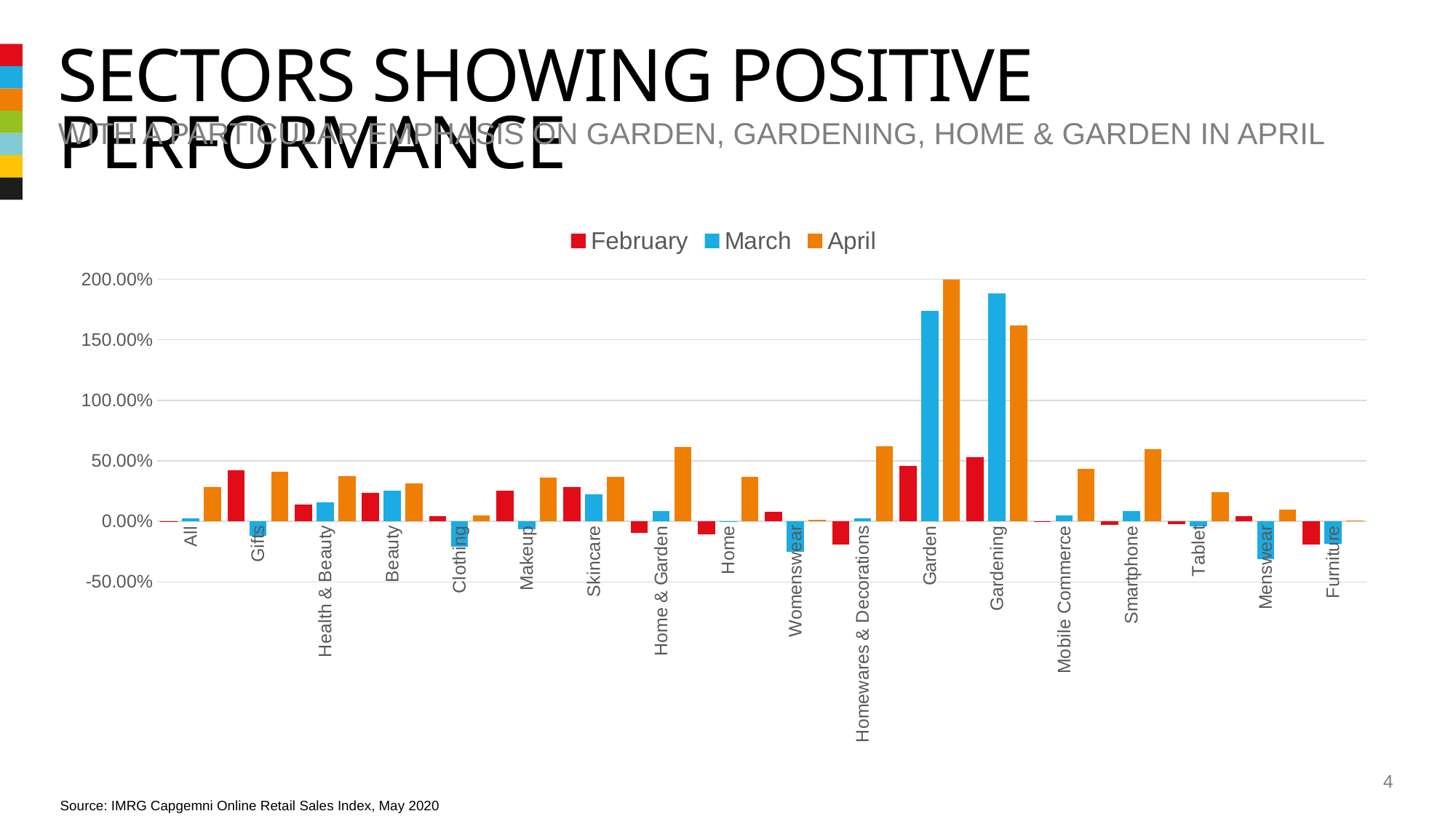
Is the April value for Home & Garden greater or less than 50.00%? greater How many sector categories are plotted along the x axis? 18 Is the April value for Garden greater or less than 150.00%? greater Is the March value for Gardening greater or less than 150.00%? greater What kind of chart is shown on the slide? bar chart Which sector has the highest April value? Garden Which is larger, the April value for Garden or the April value for Gardening? Garden Which sector has the highest March value? Gardening How many series does the legend list? 3 Which colour represents the April series in the legend? orange Which is larger, the March value for Garden or the March value for Gardening? Gardening